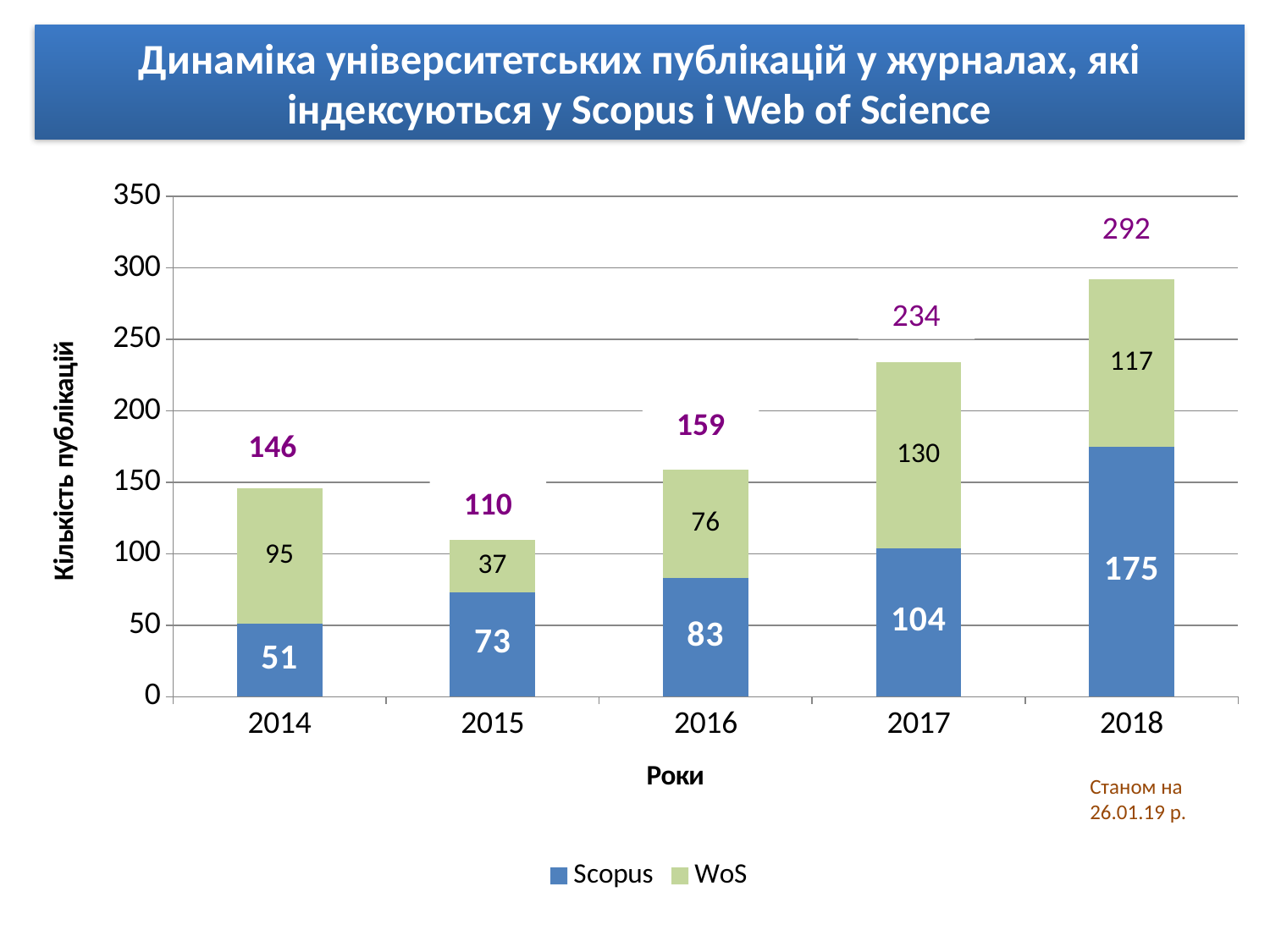
What is the total of the stacked bar for 2018? 292 How many years are shown on the x axis? 5 Which year has the highest Scopus value? 2018 What kind of chart is shown on the slide? stacked bar chart Which year has the lowest total number of publications? 2015 What is the WoS value for 2017? 130 What is the difference between the WoS values for 2014 and 2015? 58 Which is larger, the Scopus value for 2017 or the WoS value for 2017? WoS value for 2017 How many series does the legend list? 2 What is the label of the y axis? Кількість публікацій Is the total for 2017 greater or less than 200? greater What is the Scopus value for 2016? 83